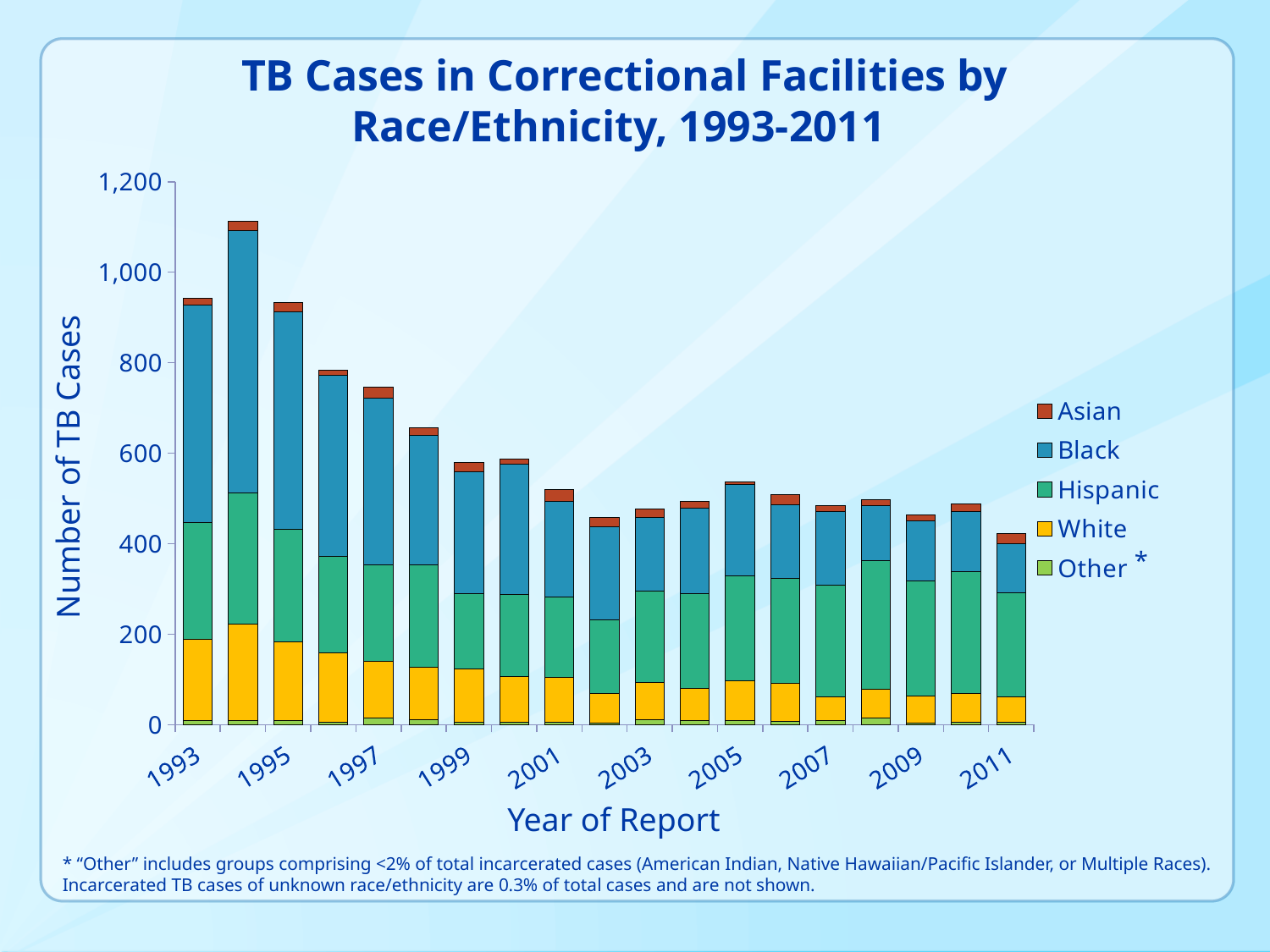
What kind of chart is shown on the slide? Stacked bar chart How many years (bars) are plotted on the x axis? 19 Which year has the lowest total number of TB cases? 2011 Is the total number of TB cases in 1994 greater or less than 1,000? greater Is the total number of TB cases in 1997 greater or less than 800? less Is the total number of TB cases in 2011 greater or less than 600? less Which year has a larger total number of TB cases, 1993 or 1996? 1993 What is the title of the chart? TB Cases in Correctional Facilities by Race/Ethnicity, 1993-2011 Which year has the highest total number of TB cases? 1994 How many series does the legend list? 5 What is the label of the x axis? Year of Report Overall, do total TB cases rise or fall from 1993 to 2011? fall